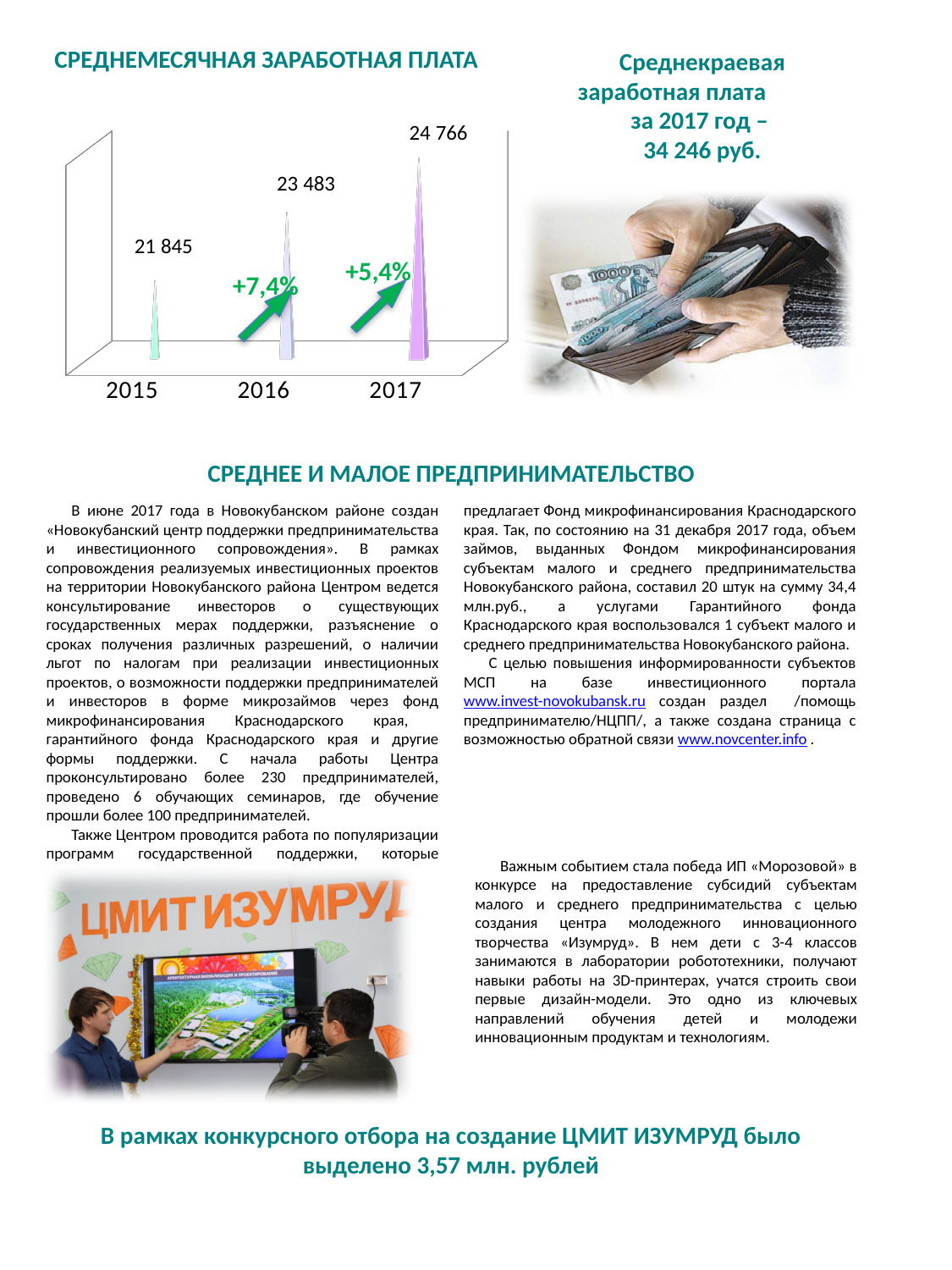
Which year has the lowest average monthly salary on the chart? 2015 Which is larger, the average monthly salary for 2016 or for 2017? 2017 Does the average monthly salary rise or fall from 2015 to 2017? rise By how much did the average monthly salary increase from 2015 to 2016? 1 638 How many years are shown on the average monthly salary chart? 3 What is the average monthly salary value shown for 2017? 24 766 By how much did the average monthly salary increase from 2016 to 2017? 1 283 What is the average monthly salary value shown for 2016? 23 483 Which year has the highest average monthly salary on the chart? 2017 What is the difference between the 2017 and 2015 average monthly salary values? 2 921 What percentage growth is annotated on the chart between 2016 and 2017? +5,4% What is the average monthly salary value shown for 2015? 21 845